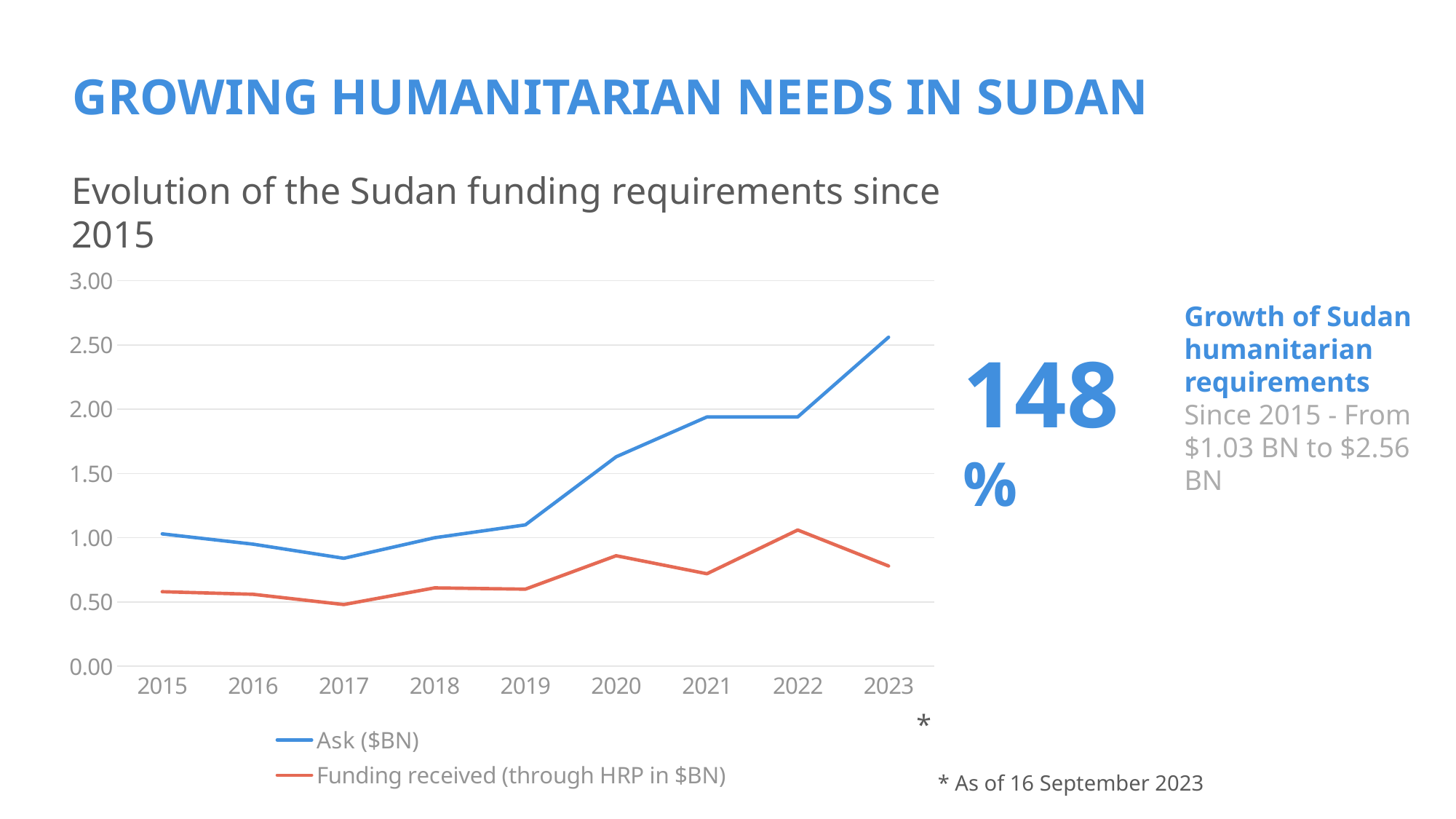
In which year is the Funding received (through HRP in $BN) value highest? 2022 How many years are plotted along the x axis? 9 Is the Funding received (through HRP in $BN) value for 2023 greater or less than 1.00? less In 2023, which series has the larger value, Ask ($BN) or Funding received (through HRP in $BN)? Ask ($BN) How many series does the legend list? 2 What kind of chart is shown on the slide? line chart In which year is the Ask ($BN) value lowest? 2017 What is the title of the chart? Evolution of the Sudan funding requirements since 2015 Does the Ask ($BN) series rise or fall overall from 2015 to 2023? rise Is the Ask ($BN) value for 2020 greater or less than 1.50? greater Is the Ask ($BN) value for 2017 greater or less than 1.00? less In which year is the Ask ($BN) value highest? 2023